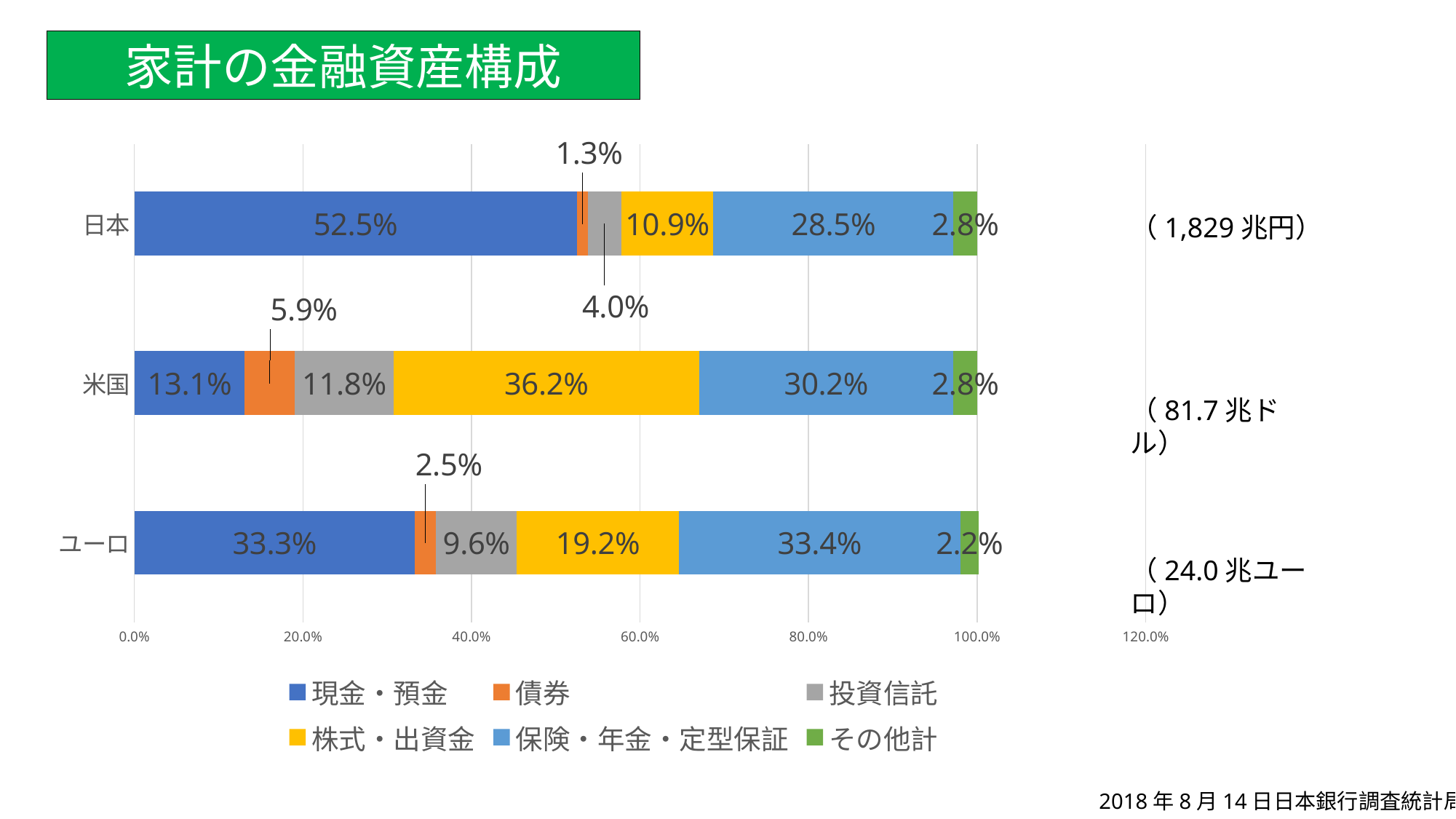
How many categories are shown on the y axis? 3 What kind of chart is shown on the slide? stacked bar chart What is the value of 投資信託 for 米国? 11.8% What is the value of 株式・出資金 for 米国? 36.2% What is the value of 保険・年金・定型保証 for ユーロ? 33.4% Which is larger, the 債券 value for 米国 or for ユーロ? 米国 Which category has the highest value for 現金・預金? 日本 What is the value of 現金・預金 for 日本? 52.5% What is the difference between the 現金・預金 values for 日本 and 米国? 39.4% What is the value of 債券 for 日本? 1.3% Which category has the lowest value for 株式・出資金? 日本 How many series does the legend list? 6